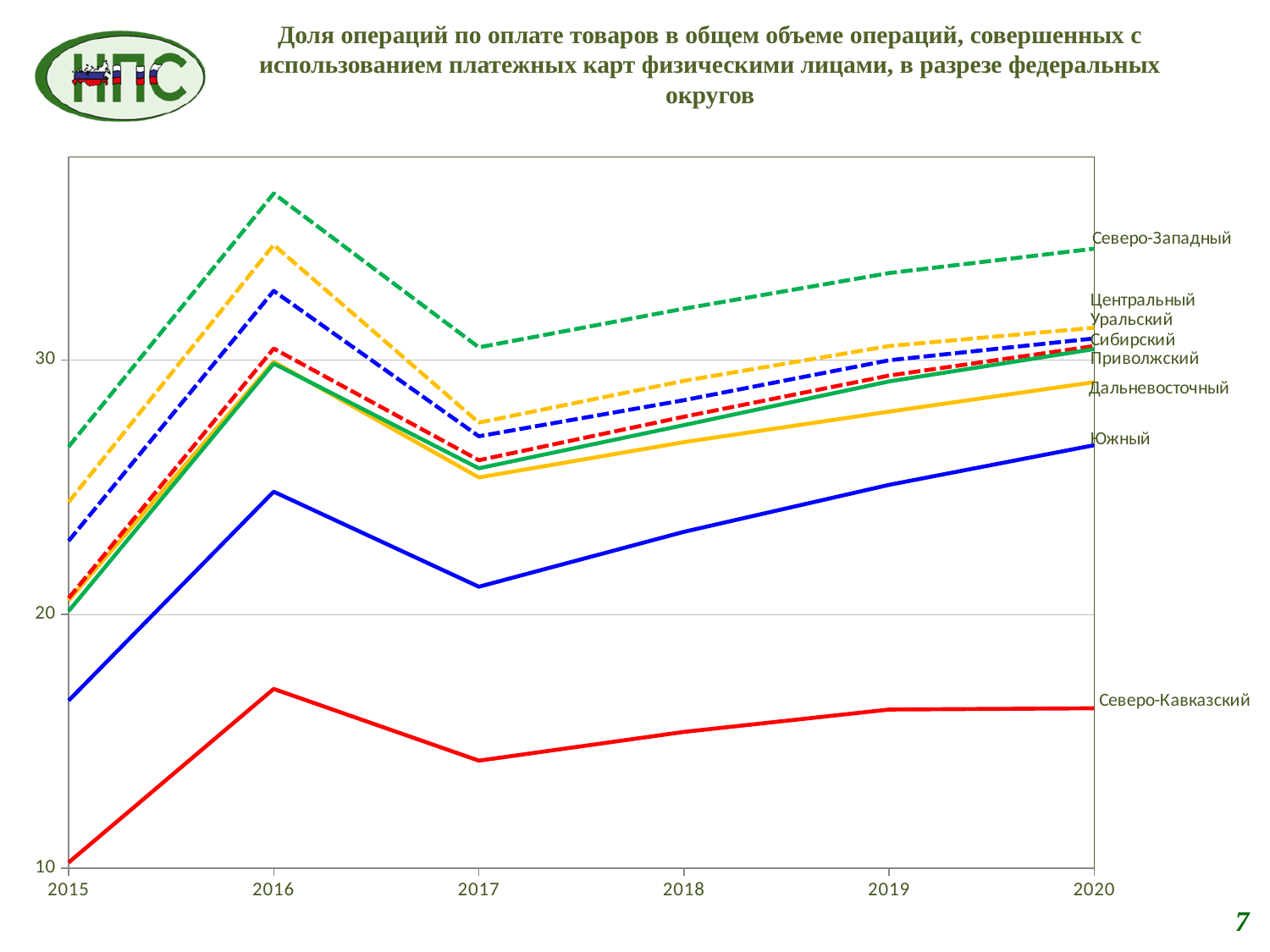
Is the value for Северо-Западный in 2016 greater or less than 30? greater Which federal district has the highest value in 2020? Северо-Западный In which year does the Северо-Западный line reach its peak? 2016 Is the value for Центральный in 2017 greater or less than 30? less Is the value for Южный in 2020 greater or less than 30? less Which federal district has the lowest value in 2020? Северо-Кавказский How many federal districts (series) are labelled on the chart? 8 Which is larger in 2020, the value for Северо-Западный or the value for Южный? Северо-Западный What kind of chart is shown on the slide? line chart How many years are shown on the x axis of the chart? 6 Do the values for Северо-Кавказский rise or fall from 2017 to 2020? rise